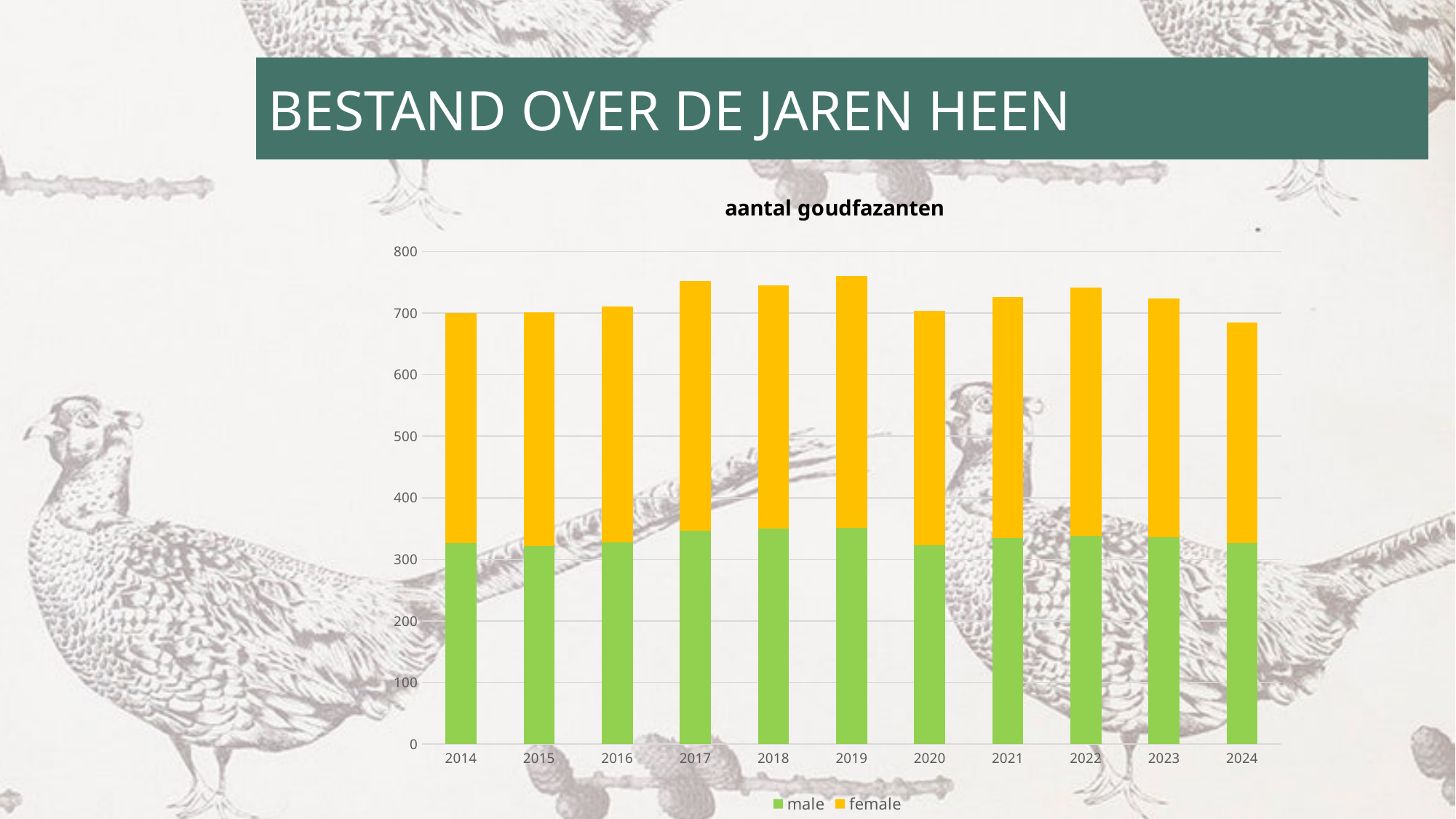
What is the title of the chart? aantal goudfazanten What kind of chart is shown on the slide? Stacked bar chart Which year has the lowest total number of goudfazanten? 2024 Is the male value for 2019 greater or less than 400? less Which colour represents the female series? Yellow Is the total value for 2017 greater or less than 700? greater Is the total value for 2024 greater or less than 700? less How many years are shown on the x axis? 11 How many series does the legend list? 2 Which is larger, the total for 2019 or the total for 2024? 2019